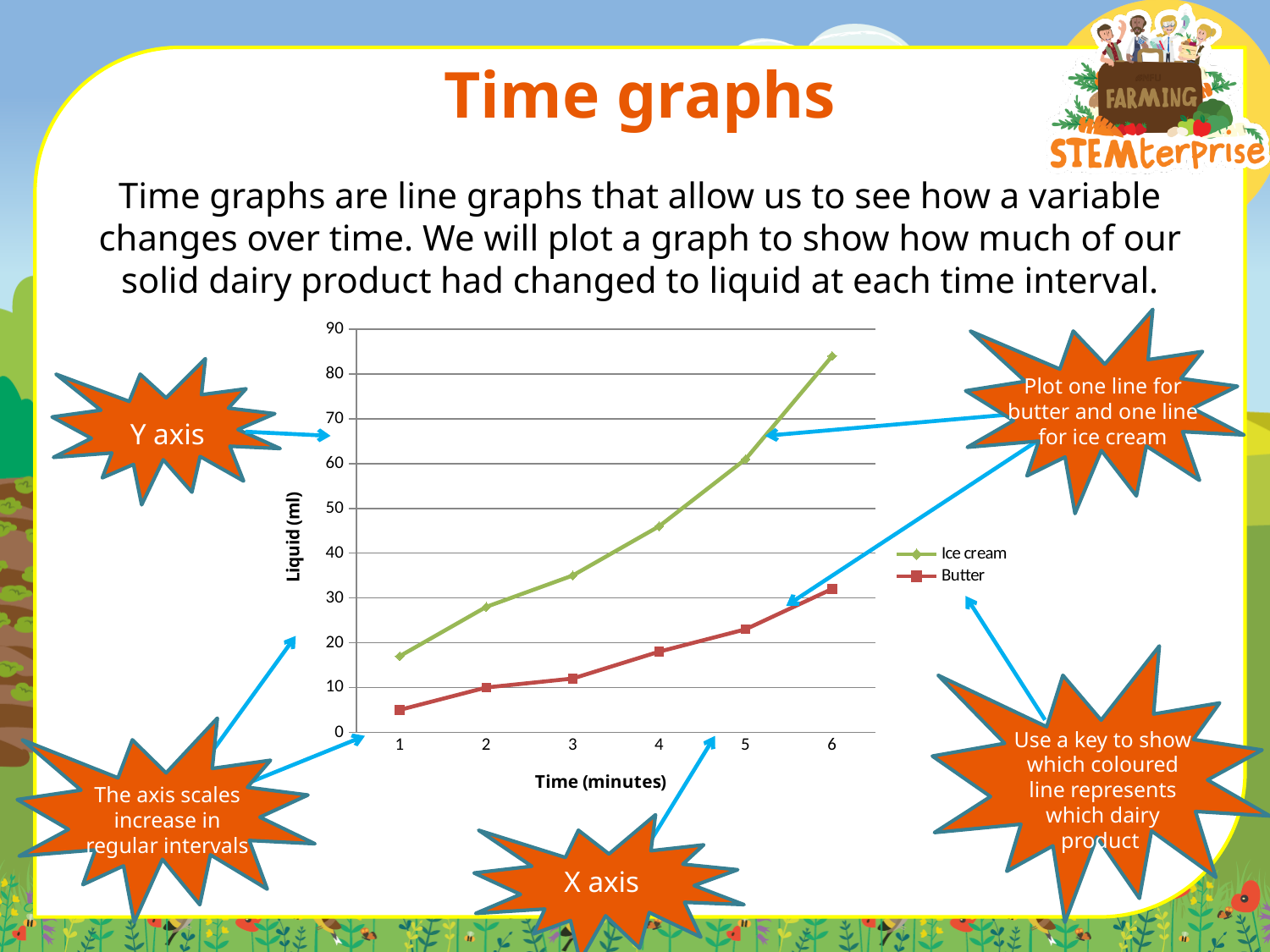
At 6 minutes, which series has the larger value, Ice cream or Butter? Ice cream How many series does the chart's legend list? 2 Is the Ice cream value at 6 minutes greater or less than 80? greater How many time points are plotted for the Ice cream line? 6 What is the title of the chart's x axis? Time (minutes) Is the Butter value at 5 minutes greater or less than 30? less What is the Butter value at 2 minutes? 10 What is the title of the chart's y axis? Liquid (ml) Does the Ice cream line rise or fall as time increases from 1 to 6 minutes? rise What kind of chart is shown on the slide? line chart Is the Butter value at 6 minutes greater or less than 40? less At which time (in minutes) does the Ice cream line reach its highest value? 6